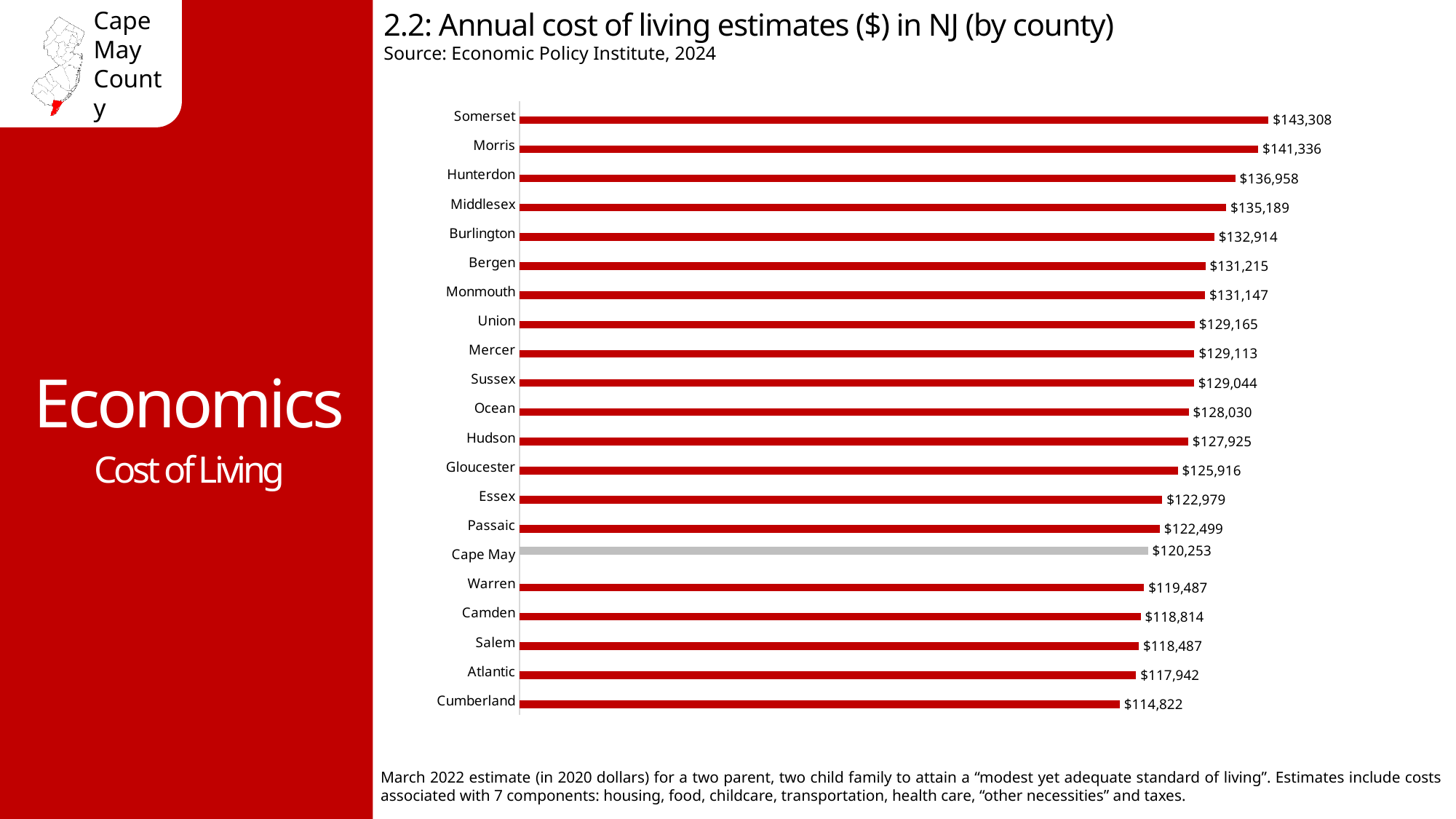
Which county's bar is shown in grey instead of red? Cape May What is the annual cost of living estimate for Somerset county? $143,308 Which county has a higher cost of living estimate, Hudson or Essex? Hudson What is the difference between the cost of living estimates for Somerset and Cumberland? $28,486 How much higher is the cost of living estimate for Cape May than for Cumberland? $5,431 What type of chart is used to show the cost of living estimates? Bar chart Which county has the highest annual cost of living estimate? Somerset How many counties are shown in the chart? 21 Which county has the lowest annual cost of living estimate? Cumberland Which county has a higher cost of living estimate, Atlantic or Warren? Warren What is the annual cost of living estimate for Gloucester county? $125,916 What is the annual cost of living estimate for Cape May county? $120,253